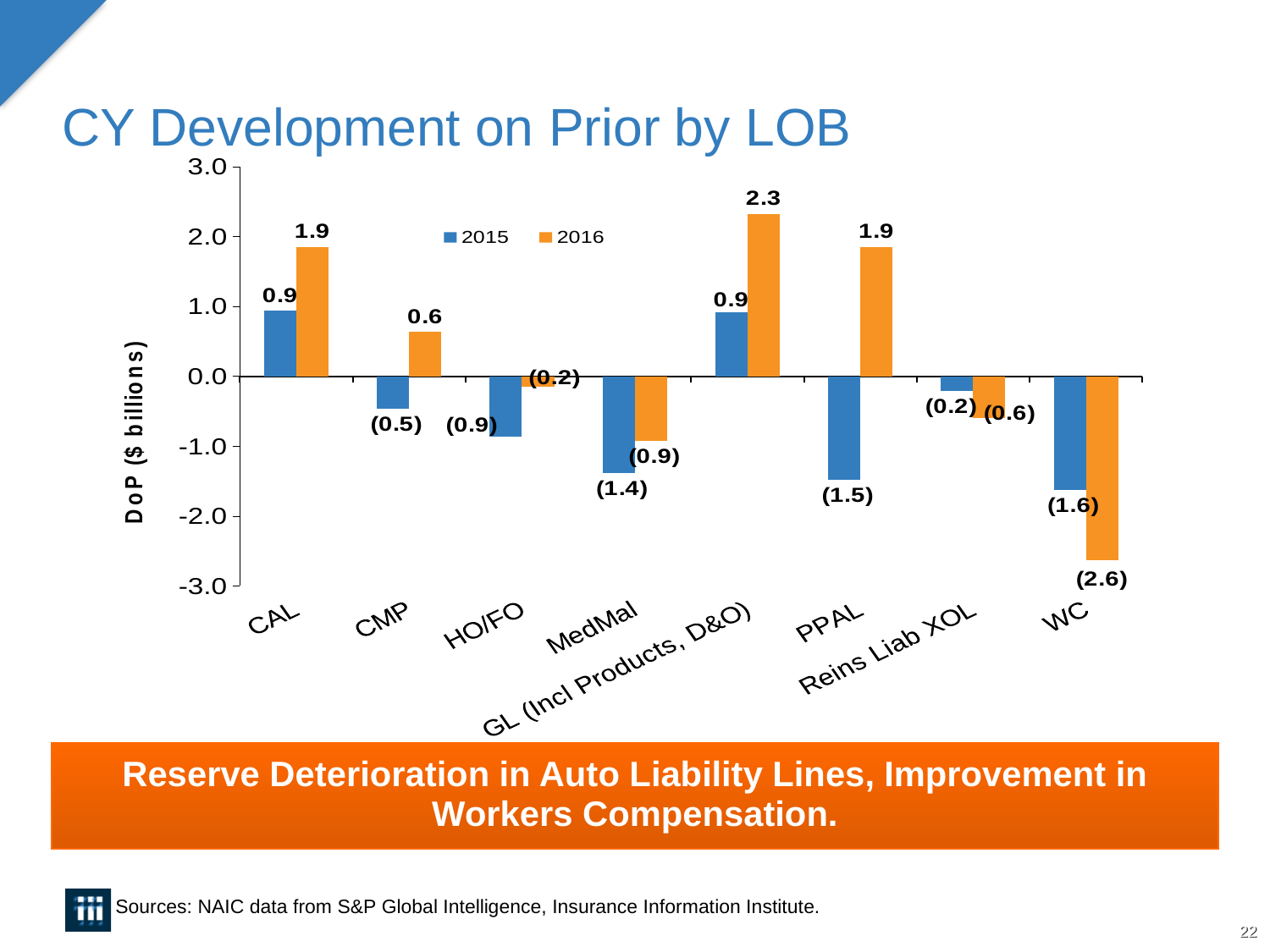
How many series does the legend list? 2 What is the title of the chart? CY Development on Prior by LOB Which line of business has the highest 2016 value? GL (Incl Products, D&O) What is the 2015 value for MedMal? (1.4) What is the 2016 value for CAL? 1.9 What kind of chart is shown on the slide? Bar chart What is the 2016 value for WC? (2.6) What is the difference between the 2016 and 2015 values for GL (Incl Products, D&O)? 1.4 What is the 2015 value for PPAL? (1.5) Which line of business has the lowest 2016 value? WC How many lines of business are shown on the x axis? 8 Which is larger for CMP, the 2015 value or the 2016 value? 2016